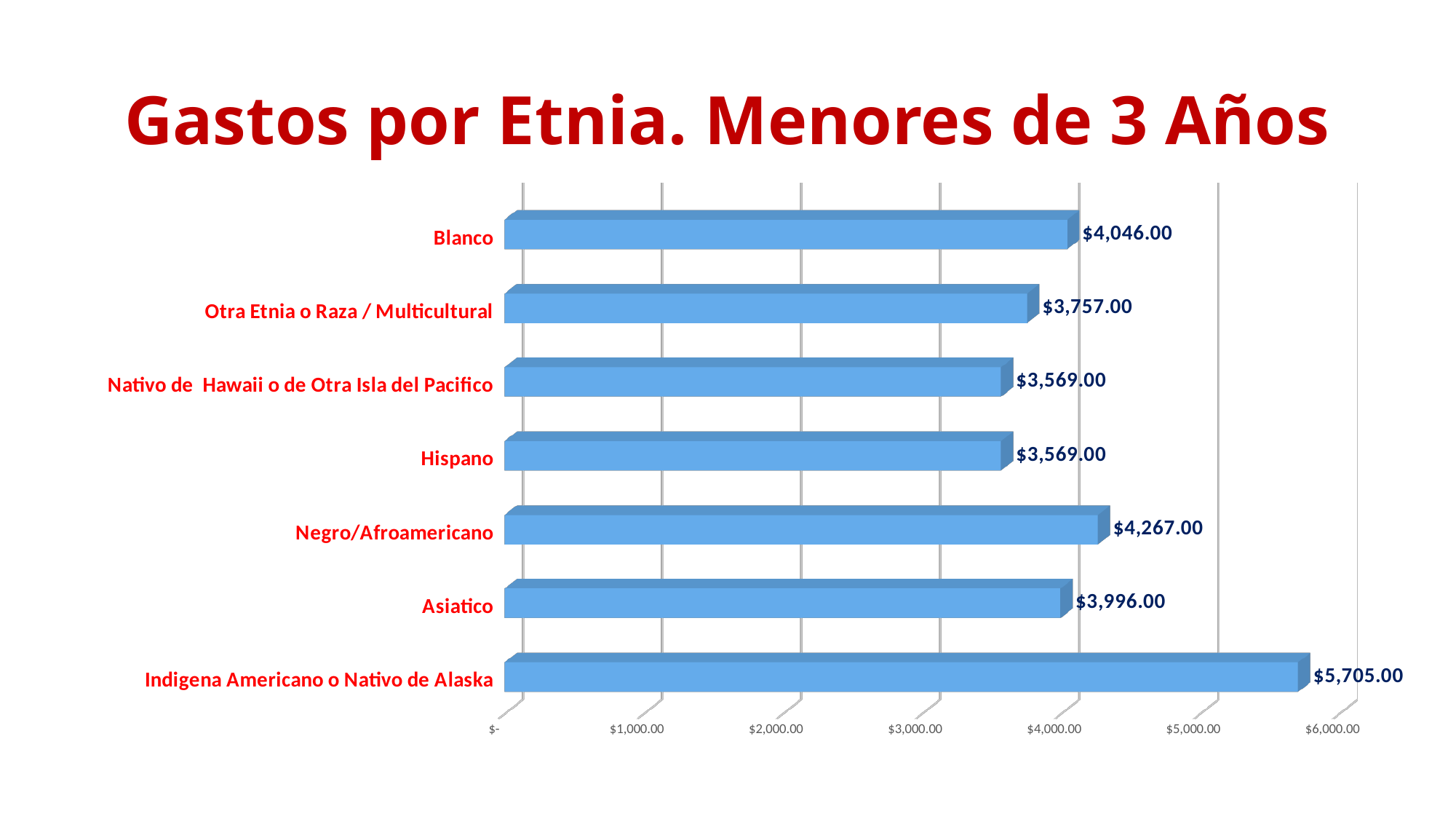
Which is larger, the value for Blanco or the value for Asiatico? Blanco What is the difference between the values for Negro/Afroamericano and Asiatico? $271.00 What is the value for Indigena Americano o Nativo de Alaska? $5,705.00 Is the value for Hispano greater or less than $4,000.00? less What is the value for Blanco? $4,046.00 What is the title of the chart? Gastos por Etnia. Menores de 3 Años What is the value for Otra Etnia o Raza / Multicultural? $3,757.00 What kind of chart is shown on the slide? bar chart How many categories are shown in the chart? 7 What is the value for Negro/Afroamericano? $4,267.00 Which category has the highest value? Indigena Americano o Nativo de Alaska What is the difference between the values for Indigena Americano o Nativo de Alaska and Blanco? $1,659.00